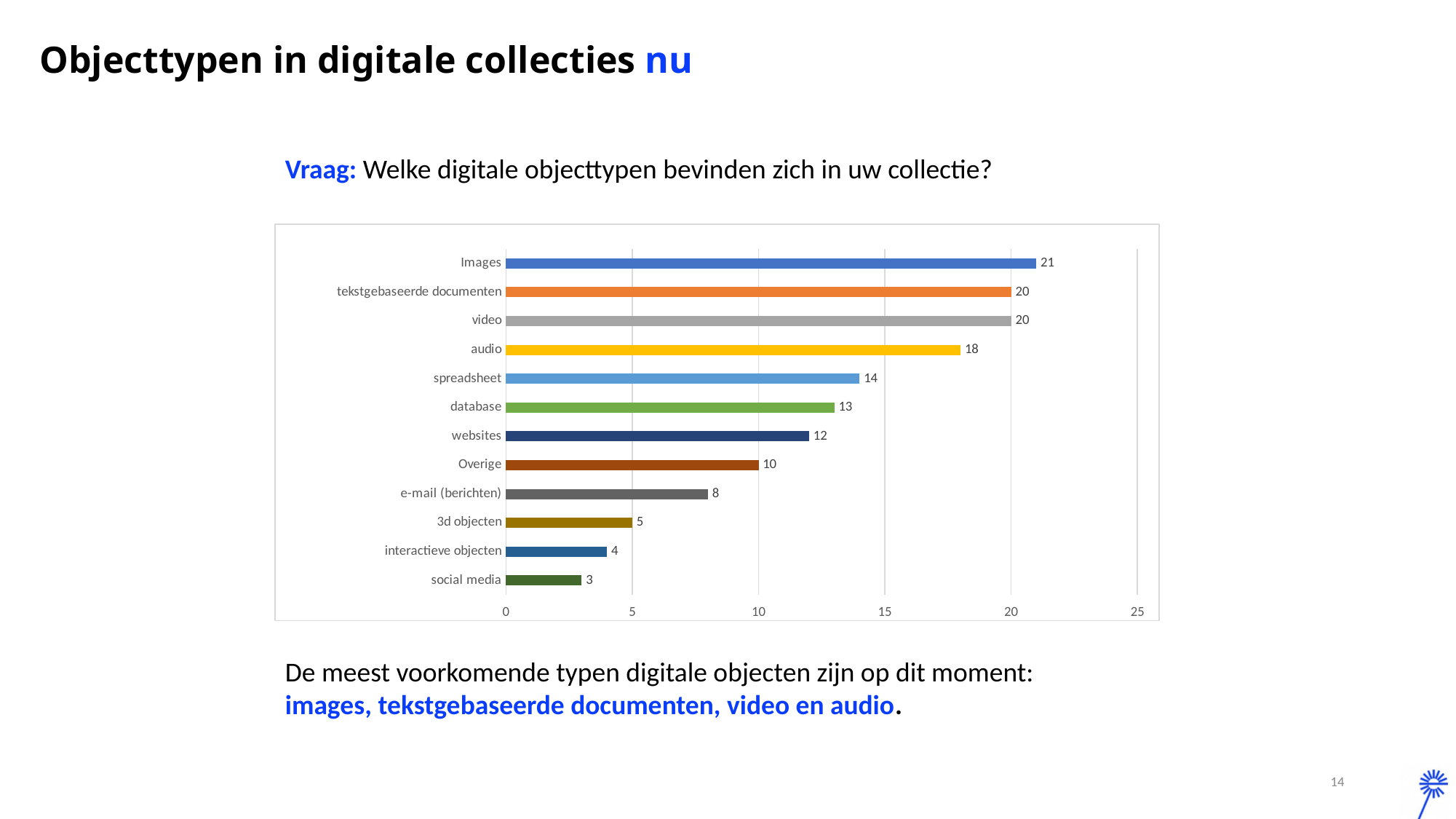
Which category has the lowest value? social media What is the value for Images? 21 What is the maximum value shown on the horizontal axis? 25 How many categories are shown in the chart? 12 What is the difference between the values for 3d objecten and social media? 2 Is the value for websites greater or less than 10? greater What is the difference between the values for Images and spreadsheet? 7 Which is larger, the value for database or the value for Overige? database What is the value for audio? 18 What is the value for e-mail (berichten)? 8 Which category has the highest value? Images What kind of chart is shown on the slide? bar chart